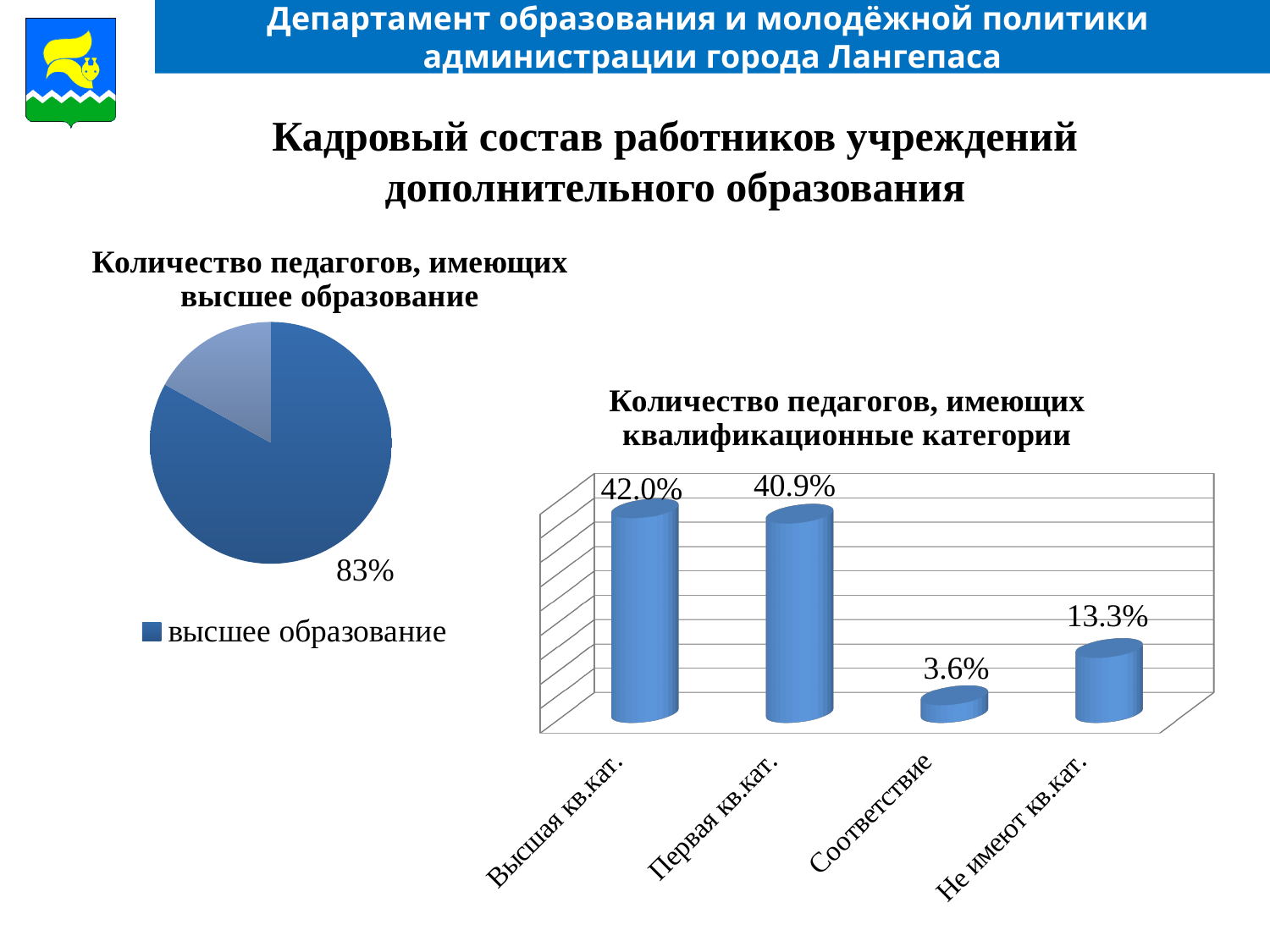
In the chart titled "Количество педагогов, имеющих квалификационные категории", which is larger: the value for "Высшая кв.кат." or for "Первая кв.кат."? Высшая кв.кат. In the chart titled "Количество педагогов, имеющих квалификационные категории", what is the value for "Соответствие"? 3.6% What kind of chart is the one titled "Количество педагогов, имеющих высшее образование"? Pie chart In the pie chart titled "Количество педагогов, имеющих высшее образование", what share is labelled for the slice "высшее образование"? 83% What kind of chart is the one titled "Количество педагогов, имеющих квалификационные категории"? Bar chart In the chart titled "Количество педагогов, имеющих квалификационные категории", what is the difference between the values for "Не имеют кв.кат." and "Соответствие"? 9.7% In the chart titled "Количество педагогов, имеющих квалификационные категории", which category has the lowest value? Соответствие In the chart titled "Количество педагогов, имеющих квалификационные категории", what is the value for "Не имеют кв.кат."? 13.3% In the chart titled "Количество педагогов, имеющих квалификационные категории", what is the value for "Первая кв.кат."? 40.9% In the chart titled "Количество педагогов, имеющих квалификационные категории", what is the value for "Высшая кв.кат."? 42.0% How many categories are shown in the chart titled "Количество педагогов, имеющих квалификационные категории"? 4 In the chart titled "Количество педагогов, имеющих квалификационные категории", which category has the highest value? Высшая кв.кат.